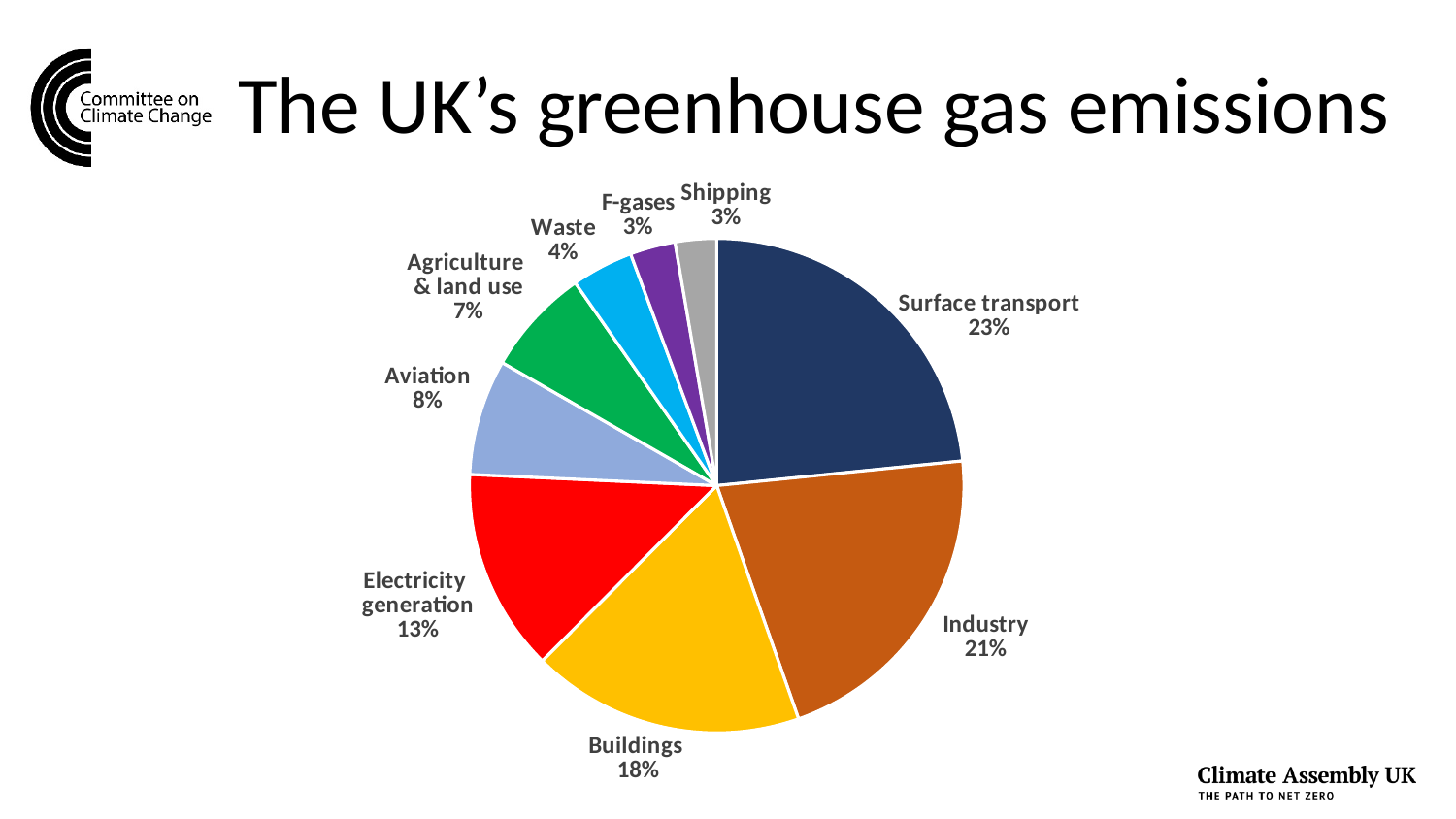
What is the combined share of emissions from F-gases and shipping? 6% Which sector has the largest share of emissions: industry or buildings? Industry Which sector has the largest share of the UK's greenhouse gas emissions? Surface transport What share of emissions comes from agriculture & land use? 7% How many percentage points larger is the surface transport share than the aviation share? 15 How many sectors are shown in the pie chart? 9 What is the title of the slide? The UK's greenhouse gas emissions What type of chart is shown on the slide? Pie chart What share of the UK's greenhouse gas emissions comes from surface transport? 23% What share of emissions does electricity generation account for? 13% What colour is the slice for electricity generation? Red What percentage of emissions is attributed to buildings? 18%